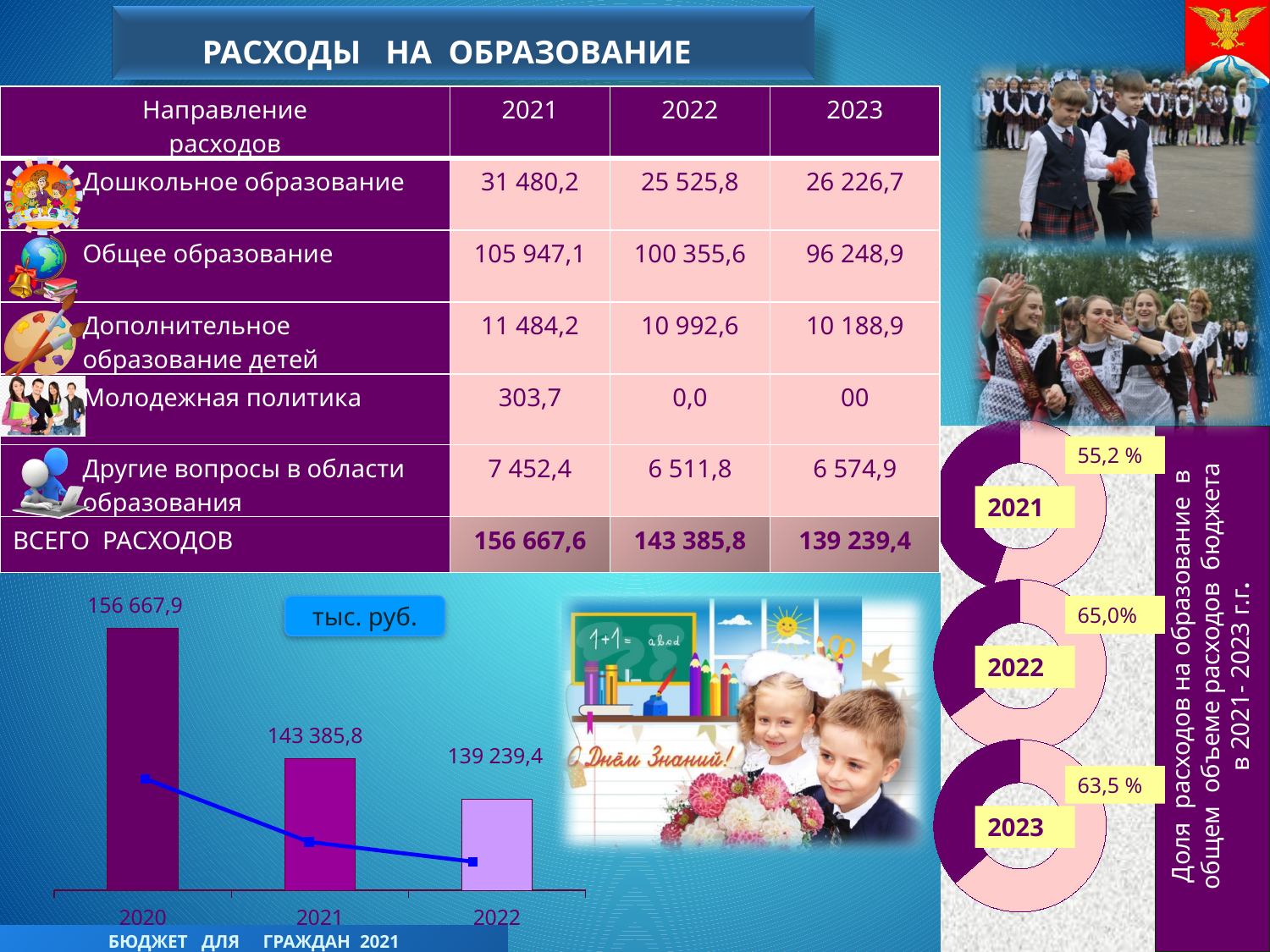
In the bar chart at the bottom left, what value is shown for 2021? 143 385,8 In the bar chart at the bottom left, which year has the highest value? 2020 In the bar chart at the bottom left, which is larger, the value for 2021 or the value for 2022? 2021 In the bar chart at the bottom left, what is the difference between the values for 2020 and 2021? 13 282,1 In the bar chart at the bottom left, do the values rise or fall from 2020 to 2022? fall In the bar chart at the bottom left, what value is shown for 2022? 139 239,4 In the bar chart at the bottom left, what value is shown for 2020? 156 667,9 In the bar chart at the bottom left, what is the difference between the values for 2021 and 2022? 4 146,4 What kind of chart is shown at the bottom left of the slide? bar chart In the bar chart at the bottom left, which year has the lowest value? 2022 How many bars are in the bar chart at the bottom left? 3 What unit is indicated in the label next to the bar chart at the bottom left? тыс. руб.